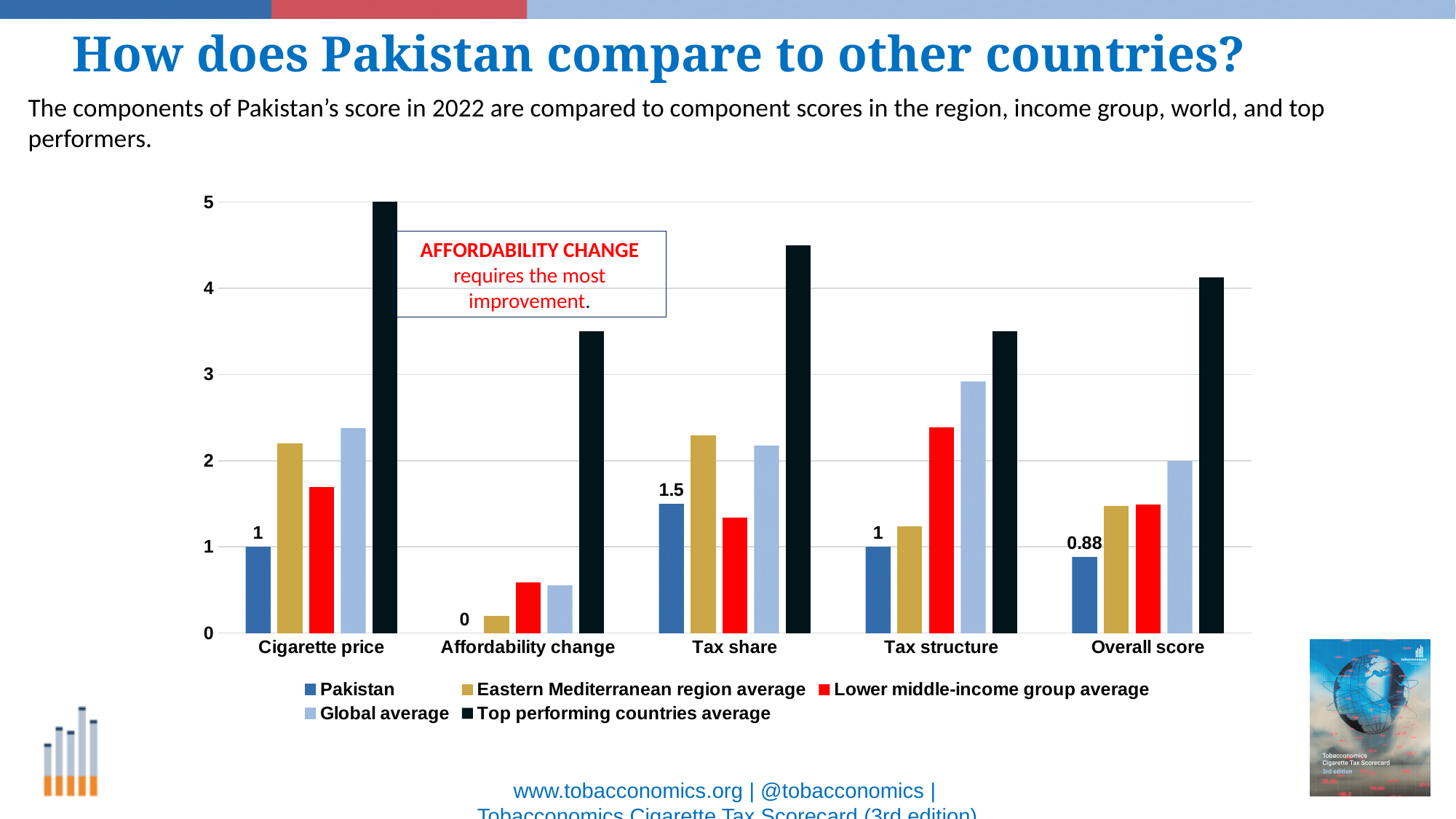
What is the Top performing countries average for Cigarette price? 5 In which component does Pakistan have its highest score? Tax share For Cigarette price, which is larger: the Eastern Mediterranean region average or the Lower middle-income group average? Eastern Mediterranean region average How much higher is Pakistan's Tax share score than its Cigarette price score? 0.5 How many series does the legend list? 5 Is the Top performing countries average for Tax share greater or less than 4? greater What is Pakistan's Overall score? 0.88 What is Pakistan's score for Affordability change? 0 How many components (categories) are shown on the x axis? 5 In which component does Pakistan have its lowest score? Affordability change What is Pakistan's score for Tax share? 1.5 What is Pakistan's score for Cigarette price? 1